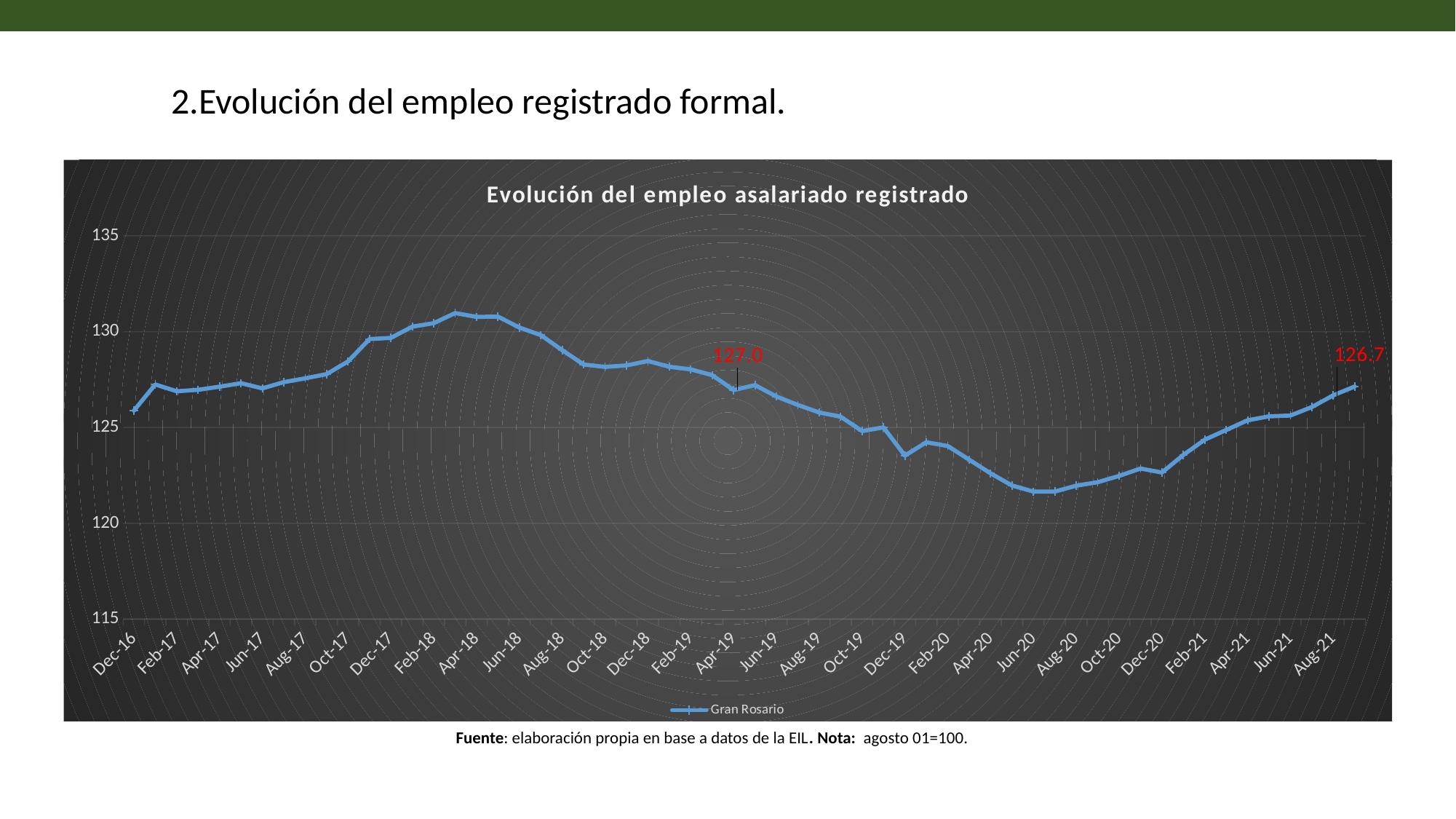
Which is larger, the labelled value for Apr-19 or for Aug-21? Apr-19 Is the value for Apr-18 greater or less than 130? greater How many series does the legend list? 1 What is the value labelled for Apr-19 on the chart? 127.0 What kind of chart is shown on the slide? line chart What is the value labelled for Aug-21, the last point on the chart? 126.7 What is the difference between the labelled values for Apr-19 and Aug-21? 0.3 What is the name of the series shown in the legend? Gran Rosario Does the line rise or fall between Apr-18 and Jun-20? fall Is the value for Jun-20 greater or less than 125? less Is the value for Dec-16 greater or less than 130? less Does the line rise or fall between Aug-20 and Aug-21? rise